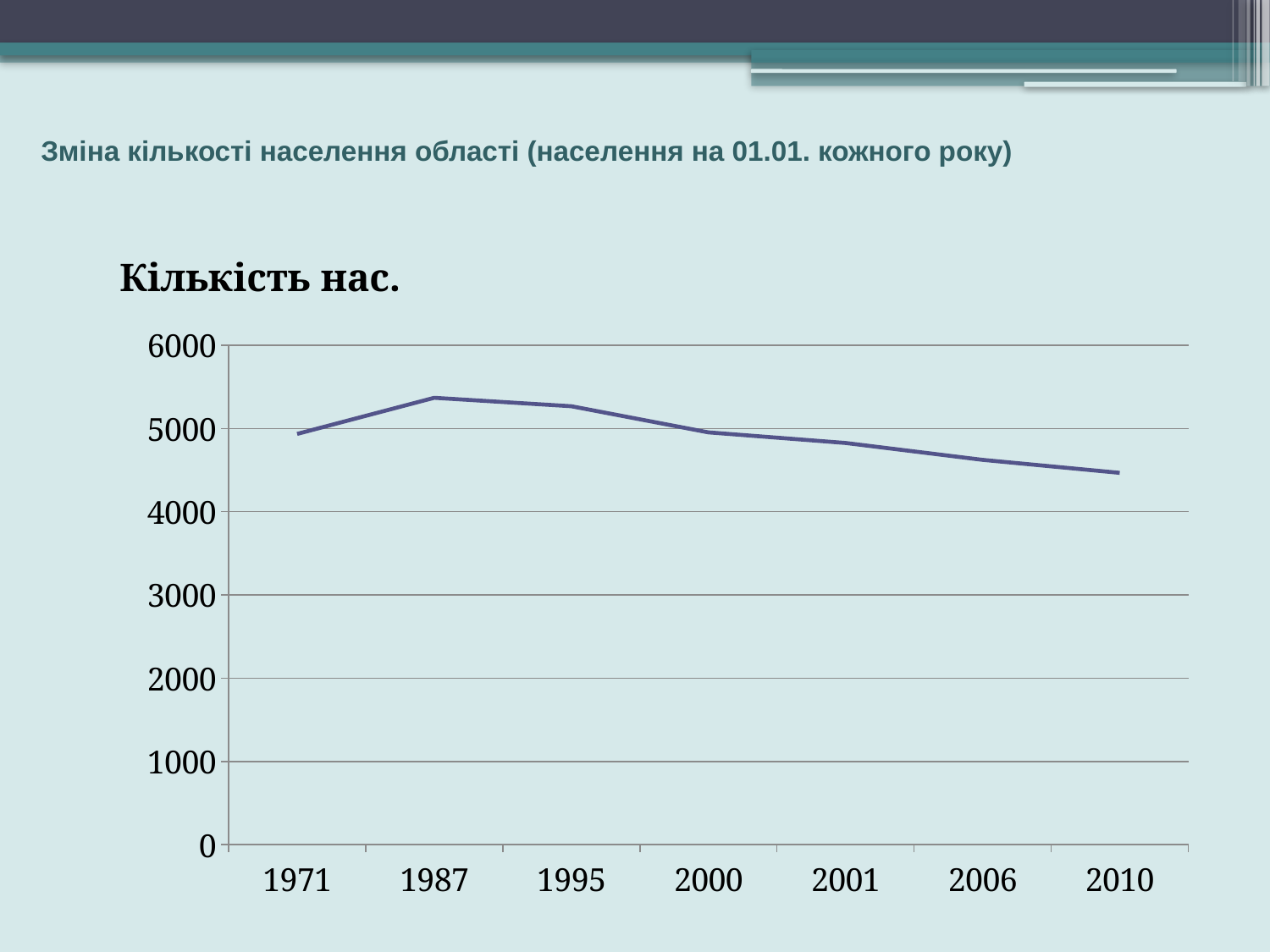
Is the value for 2010 greater or less than 5000? less What is the title of the chart? Кількість нас. Do the values rise or fall from 1987 to 2010? fall What kind of chart is shown on the slide? line chart Which is larger, the value for 1987 or the value for 2010? 1987 Which year has the highest value on the chart? 1987 Which is larger, the value for 1971 or the value for 2010? 1971 Is the value for 1987 greater or less than 5000? greater Is the value for 2006 greater or less than 5000? less Which year has the lowest value on the chart? 2010 How many years are plotted along the x axis of the chart? 7